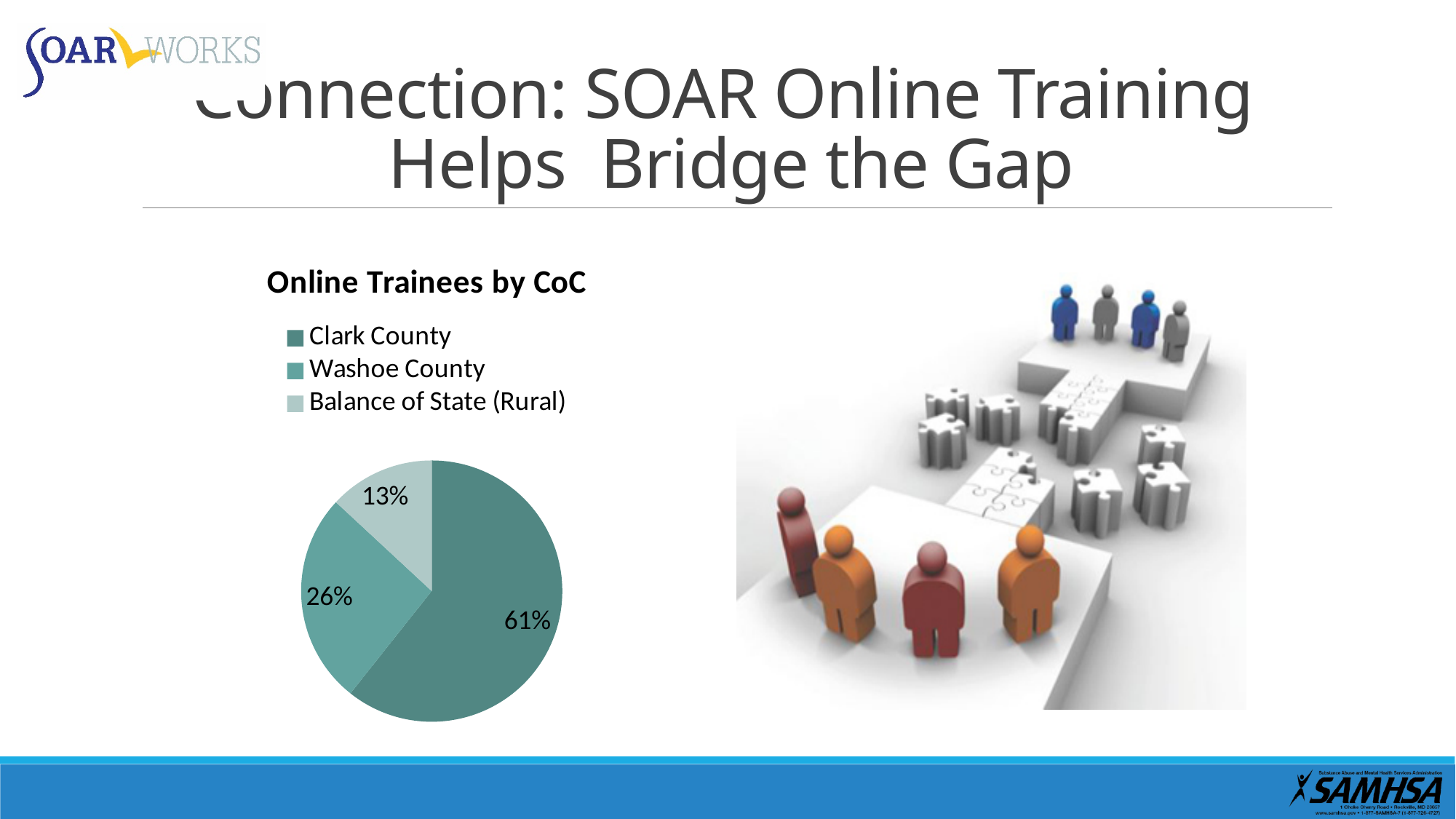
What is the difference in percentage points between Clark County and Washoe County? 35 What is the difference in percentage points between Washoe County and Balance of State (Rural)? 13 How many categories does the pie chart show? 3 Which has a larger share of online trainees, Washoe County or Balance of State (Rural)? Washoe County What share of online trainees is from Washoe County? 26% Which CoC has the smallest share of online trainees? Balance of State (Rural) What type of chart is shown on the slide? pie chart Which legend entry is listed first in the chart's legend? Clark County What is the title of the chart? Online Trainees by CoC What share of online trainees is from Balance of State (Rural)? 13% What share of online trainees is from Clark County? 61% Which CoC has the largest share of online trainees? Clark County